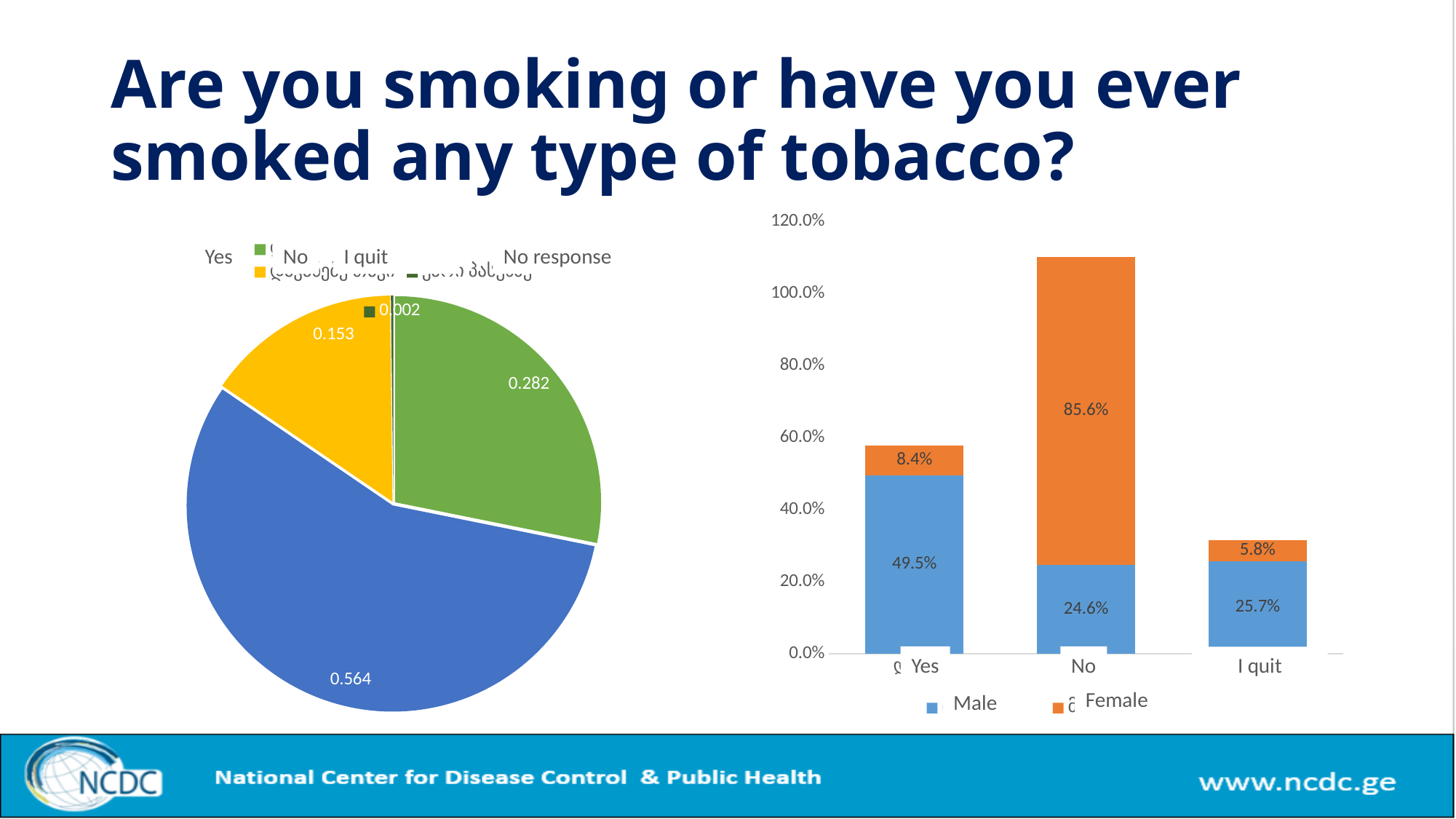
How many categories are shown on the x axis of the bar chart on the right? 3 In the bar chart on the right, is the Female value larger for Yes or for I quit? Yes In the pie chart on the left, what is the value of the largest slice? 0.564 In the bar chart on the right, what is the Female value for the No category? 85.6% In the bar chart on the right, which category has the highest Female value? No In the bar chart on the right, what is the total of the stacked bar for the No category? 110.2% In the bar chart on the right, what is the Female value for the I quit category? 5.8% In the bar chart on the right, which category has the lowest Female value? I quit In the pie chart on the left, what is the value of the smallest slice? 0.002 In the bar chart on the right, what is the difference between the Male value for Yes and the Male value for I quit? 23.8% How many series does the legend of the bar chart on the right list? 2 In the bar chart on the right, what is the Male value for the Yes category? 49.5%